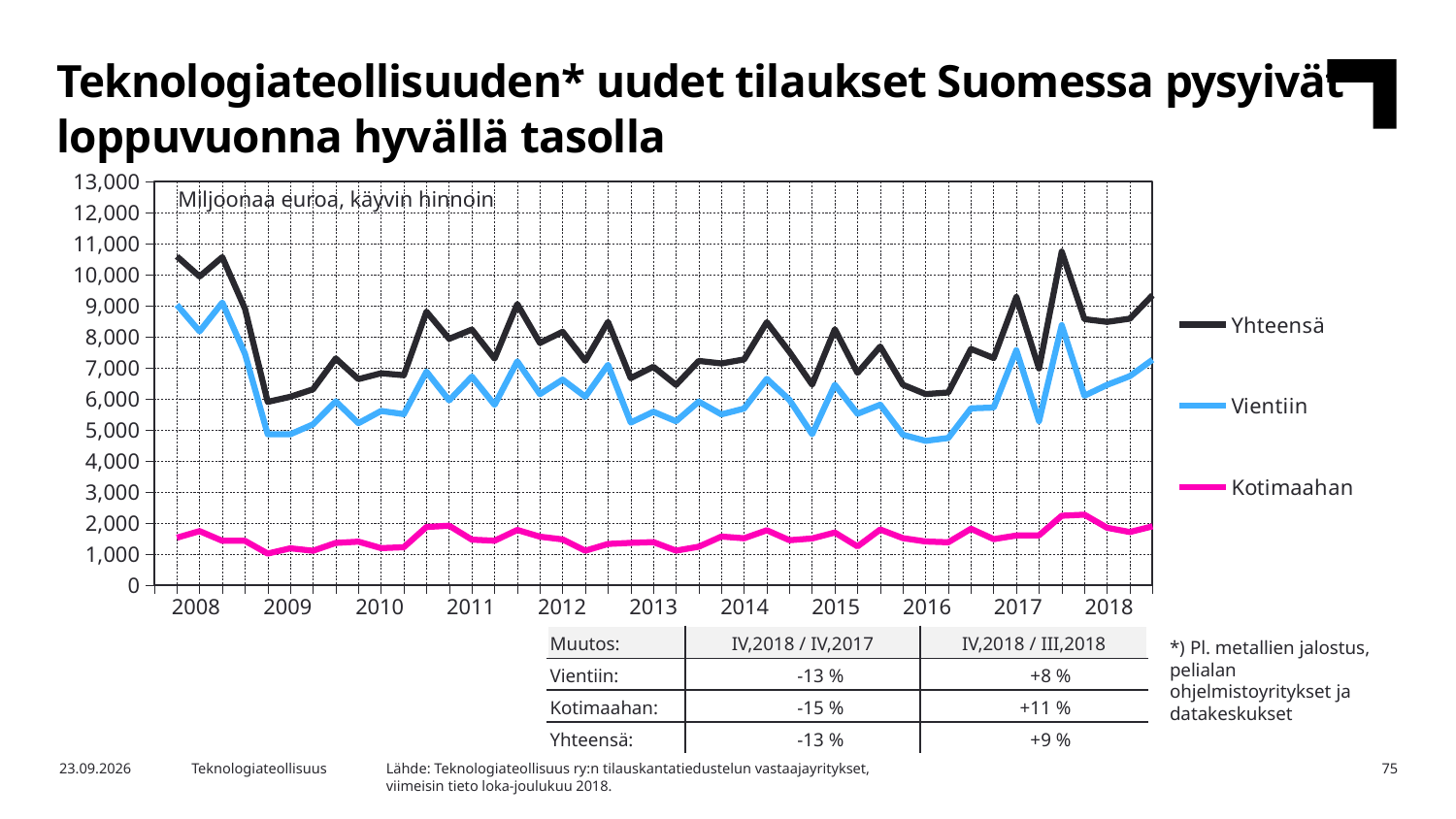
Which series are listed in the chart legend? Yhteensä, Vientiin, Kotimaahan What kind of chart is shown on the slide? line chart Which series has the highest values throughout the chart? Yhteensä How many years are labelled on the x axis? 11 Which series has the lowest values throughout the chart? Kotimaahan Is the value for Yhteensä at the start of 2008 greater or less than 10,000? greater Is the value for Kotimaahan in 2018 greater or less than 3,000? less What unit label is shown inside the chart area? Miljoonaa euroa, käyvin hinnoin Does the Yhteensä line rise or fall from 2008 to 2009? fall Which is larger in 2017, the value for Vientiin or the value for Kotimaahan? Vientiin How many series does the legend list? 3 Is the value for Vientiin in 2016 greater or less than 6,000? less